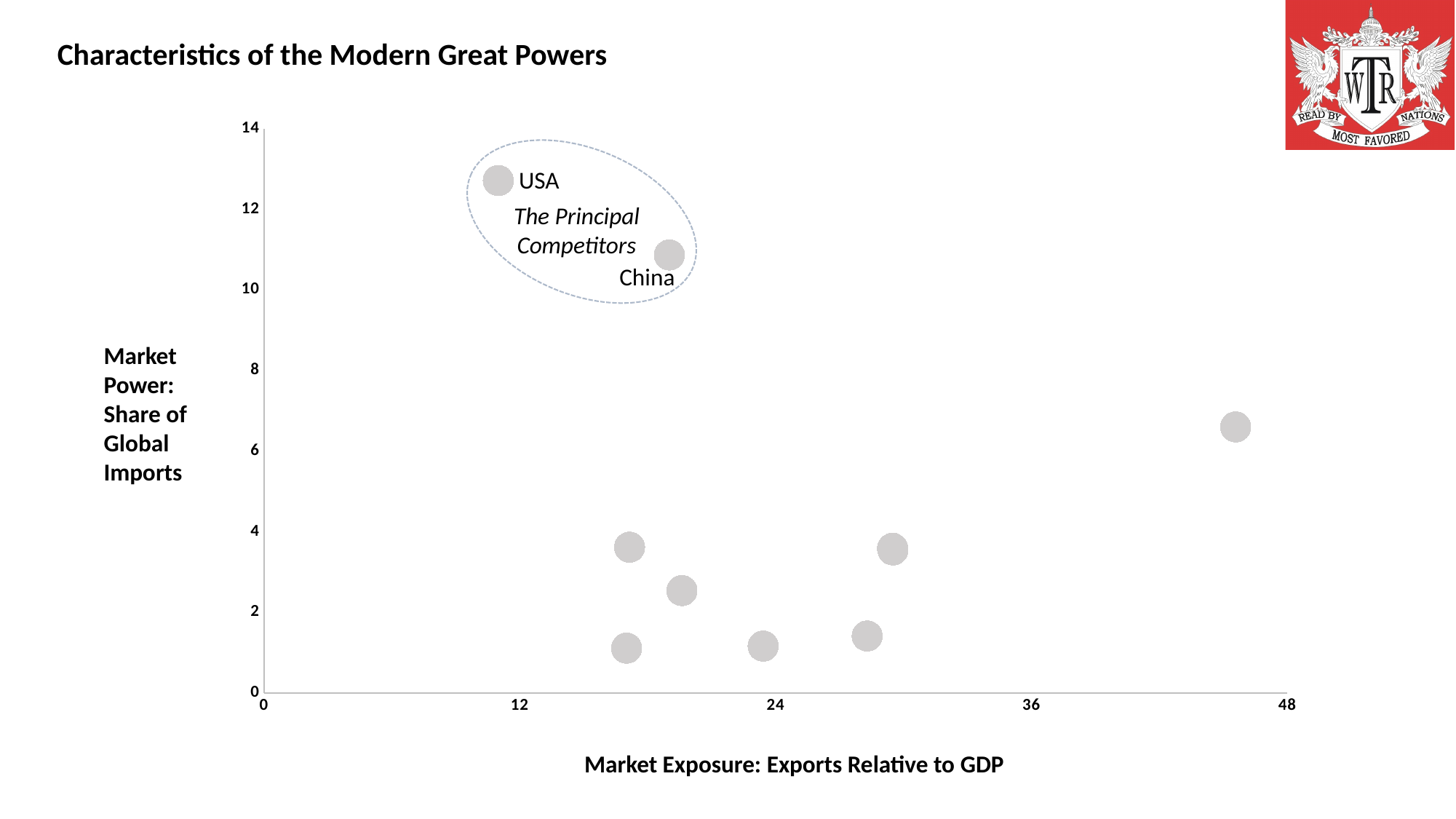
Is the Market Power value for USA greater or less than 12? greater What is the label of the horizontal axis? Market Exposure: Exports Relative to GDP Is the Market Power value for China greater or less than 12? less Is the Market Power value for China greater or less than 10? greater Which has a higher share of global imports, USA or China? USA Which has a higher Market Exposure (exports relative to GDP), USA or China? China What is the title of the chart on the slide? Characteristics of the Modern Great Powers What kind of chart is shown on the slide? scatter chart Which labeled country has the highest Market Power (share of global imports)? USA